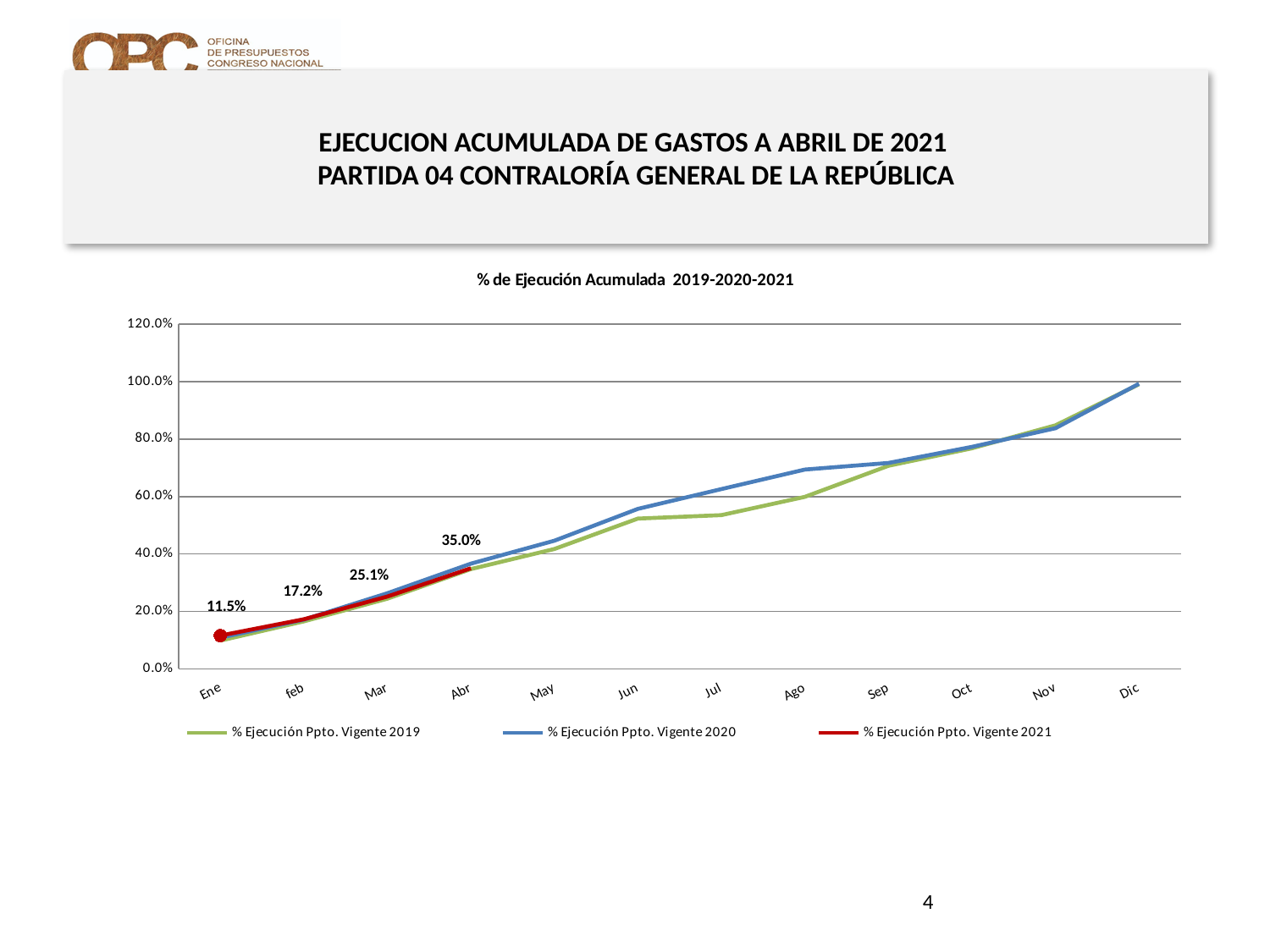
In Ago, which series has the larger value, % Ejecución Ppto. Vigente 2019 or % Ejecución Ppto. Vigente 2020? % Ejecución Ppto. Vigente 2020 What is the difference between the 2021 values for Abr and Ene? 23.5% What is the difference between the 2021 values for Abr and Mar? 9.9% What is the value of % Ejecución Ppto. Vigente 2021 for Mar? 25.1% Is the value for % Ejecución Ppto. Vigente 2020 in Ago greater or less than 60.0%? greater What kind of chart is shown on the slide? Line chart Which month has the highest value for the % Ejecución Ppto. Vigente 2021 series? Abr How many months are shown on the x axis? 12 What is the value of % Ejecución Ppto. Vigente 2021 for Abr? 35.0% What is the value of % Ejecución Ppto. Vigente 2021 for Ene? 11.5% Do the values of the % Ejecución Ppto. Vigente 2020 series rise or fall from Ene to Dic? Rise How many series does the legend list? 3